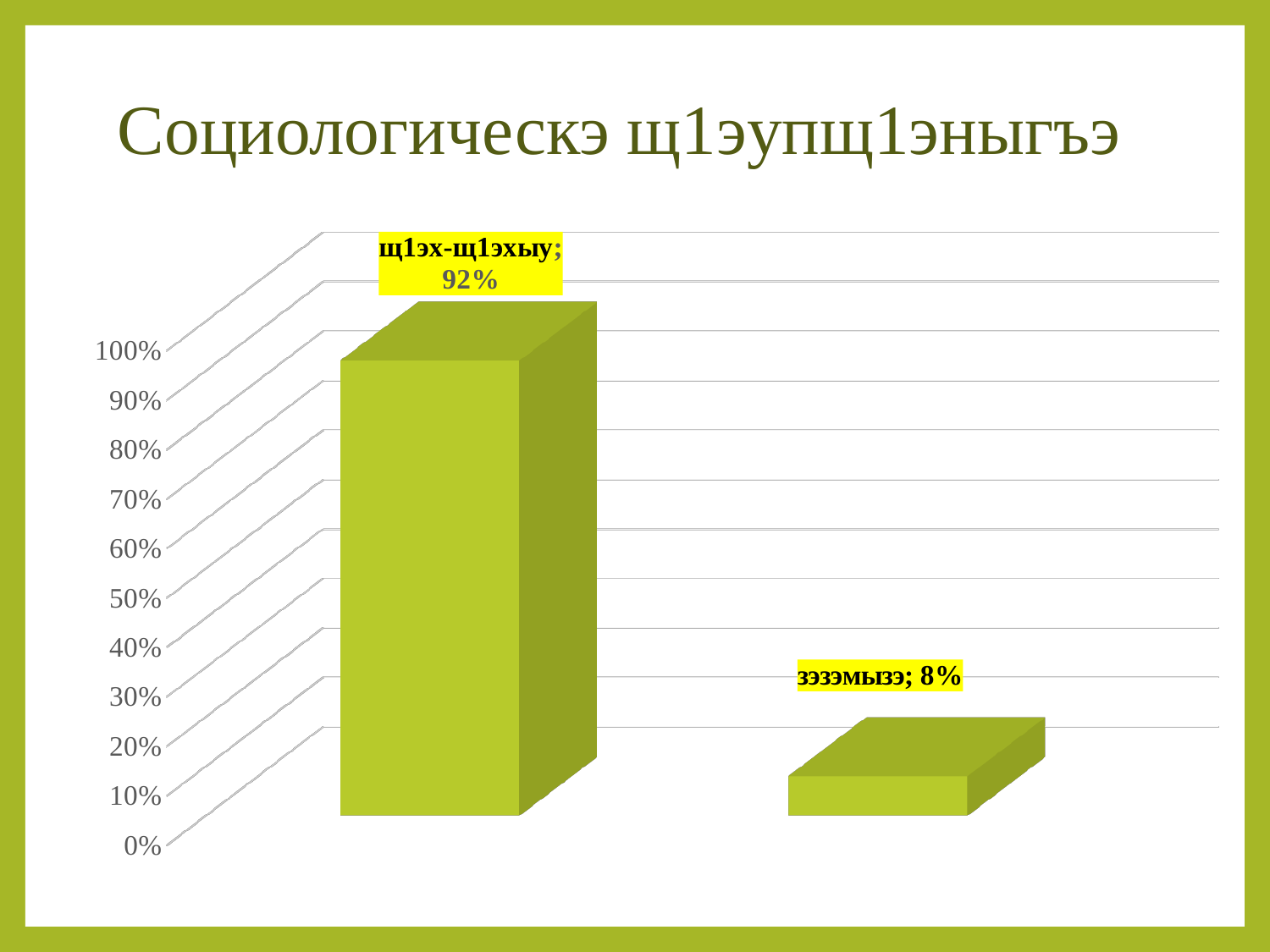
Which category has the highest value? щ1эх-щ1эхыу Which category has the lowest value? зэзэмызэ What is the value for щ1эх-щ1эхыу? 92% What is the difference between the values for щ1эх-щ1эхыу and зэзэмызэ? 84% Is the value for зэзэмызэ greater or less than 20%? less What is the total of the two values shown in the chart? 100% What is the value for зэзэмызэ? 8% Which is larger, the value for щ1эх-щ1эхыу or the value for зэзэмызэ? щ1эх-щ1эхыу How many categories are plotted in the chart? 2 Is the value for щ1эх-щ1эхыу greater or less than 80%? greater What is the title of the slide containing the chart? Социологическэ щ1эупщ1эныгъэ What kind of chart is shown on the slide? bar chart